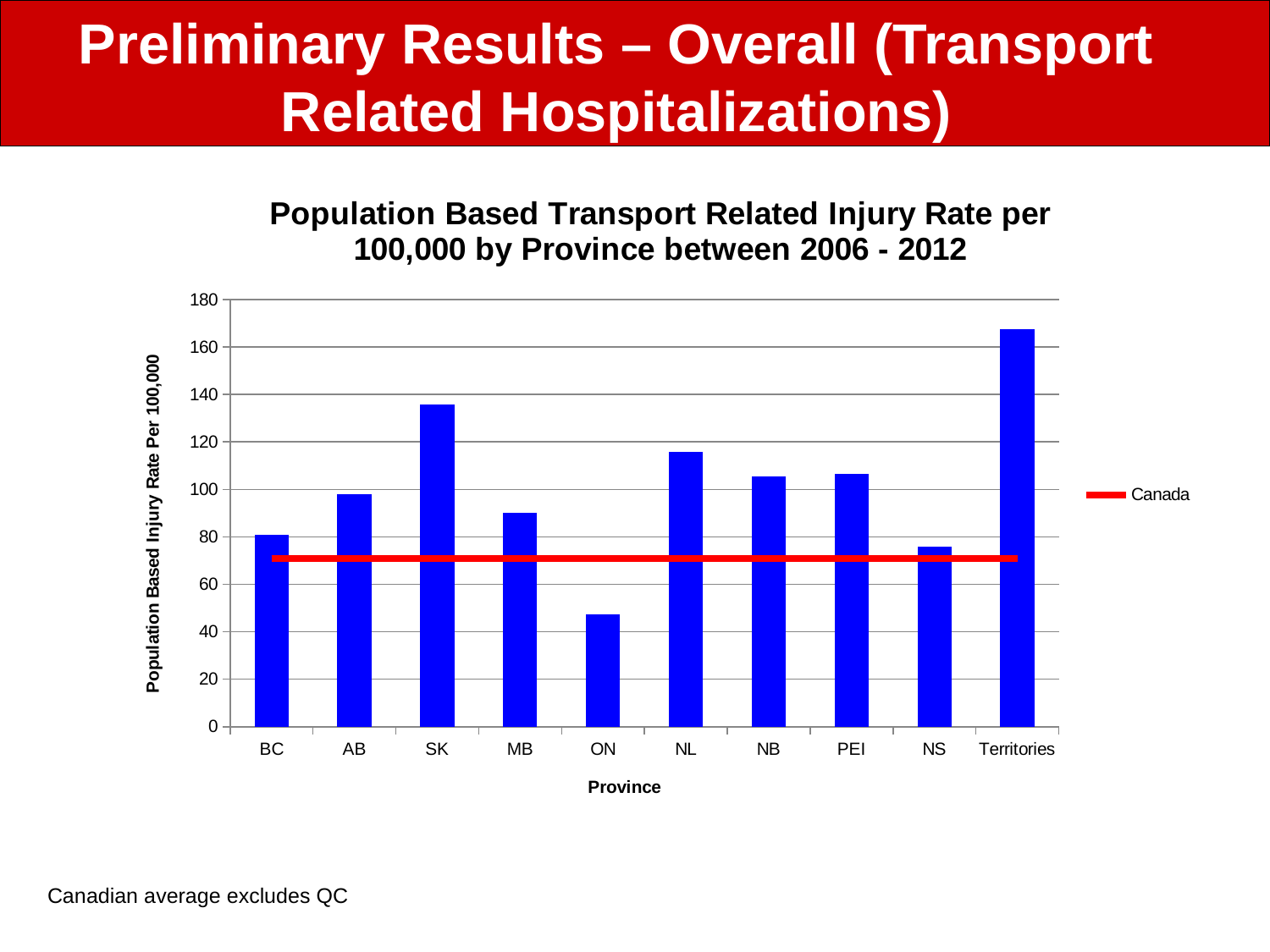
Which province or region has the highest population based transport related injury rate? Territories How many entries does the legend list? 1 Is the injury rate for ON greater or less than 60? less Which has a higher injury rate, SK or NL? SK Is the injury rate for Territories greater or less than 160? greater Is the injury rate for SK greater or less than 120? greater What kind of chart is shown on the slide? bar chart Which province has the lowest population based transport related injury rate? ON What does the red horizontal line represent according to the legend? Canada How many provinces or regions are shown on the x axis? 10